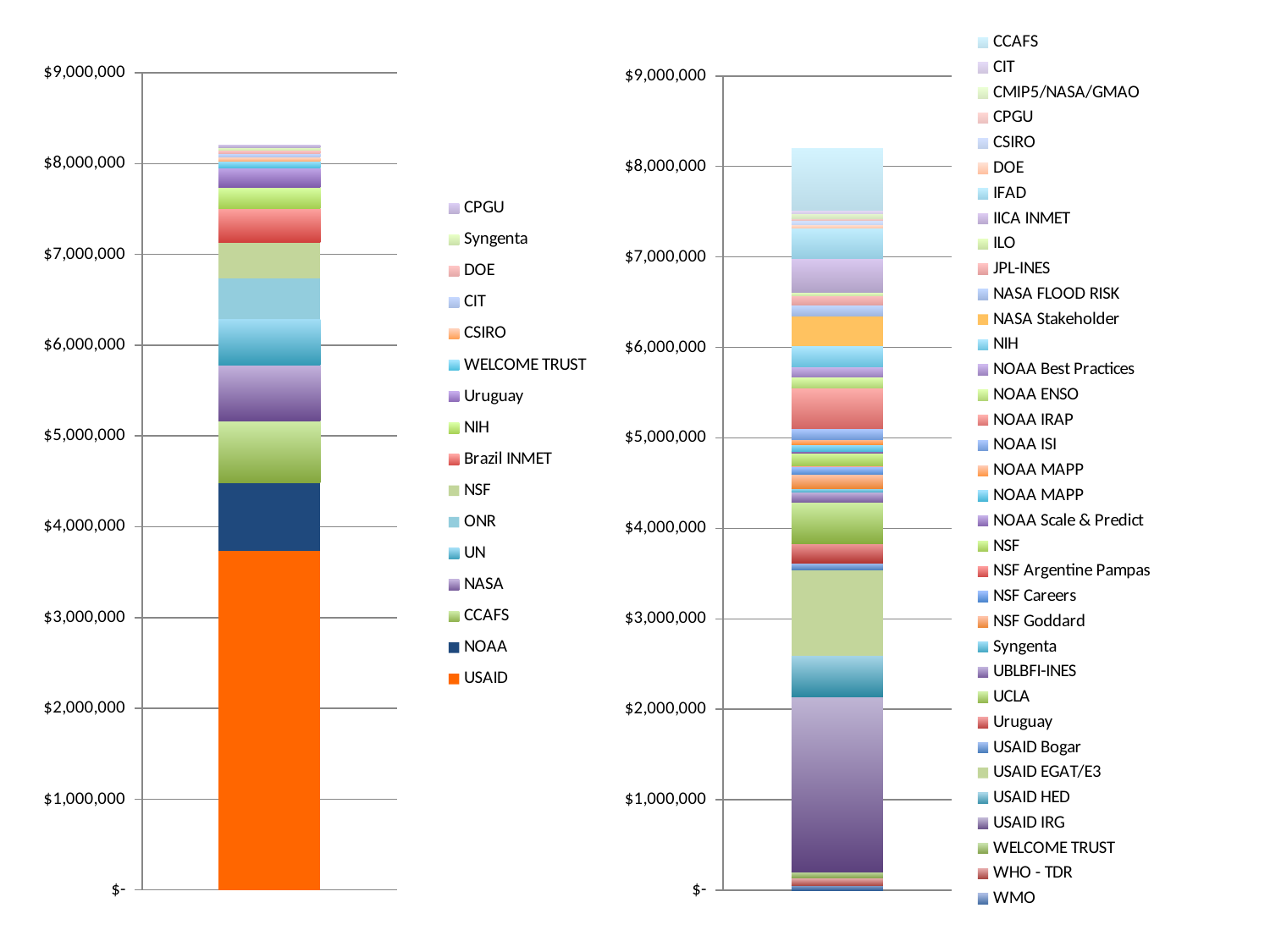
What is the highest value shown on the y axis of the left chart? $9,000,000 In the left chart, is the USAID segment greater or less than $4,000,000? less In the right chart, which series has the largest segment in the stacked bar? USAID IRG In the right chart, is the total height of the stacked bar greater or less than $8,000,000? greater In the left chart, which segment is larger, USAID or NOAA? USAID How many series does the legend of the right chart list? 35 How many stacked bars are plotted in the left chart? 1 In the left chart, which series has the largest segment in the stacked bar? USAID How many series does the legend of the left chart list? 16 What kind of chart is the chart on the left side of the slide? stacked bar chart In the right chart, which segment is larger, USAID EGAT/E3 or USAID HED? USAID EGAT/E3 In the left chart, is the USAID segment greater or less than $3,000,000? greater